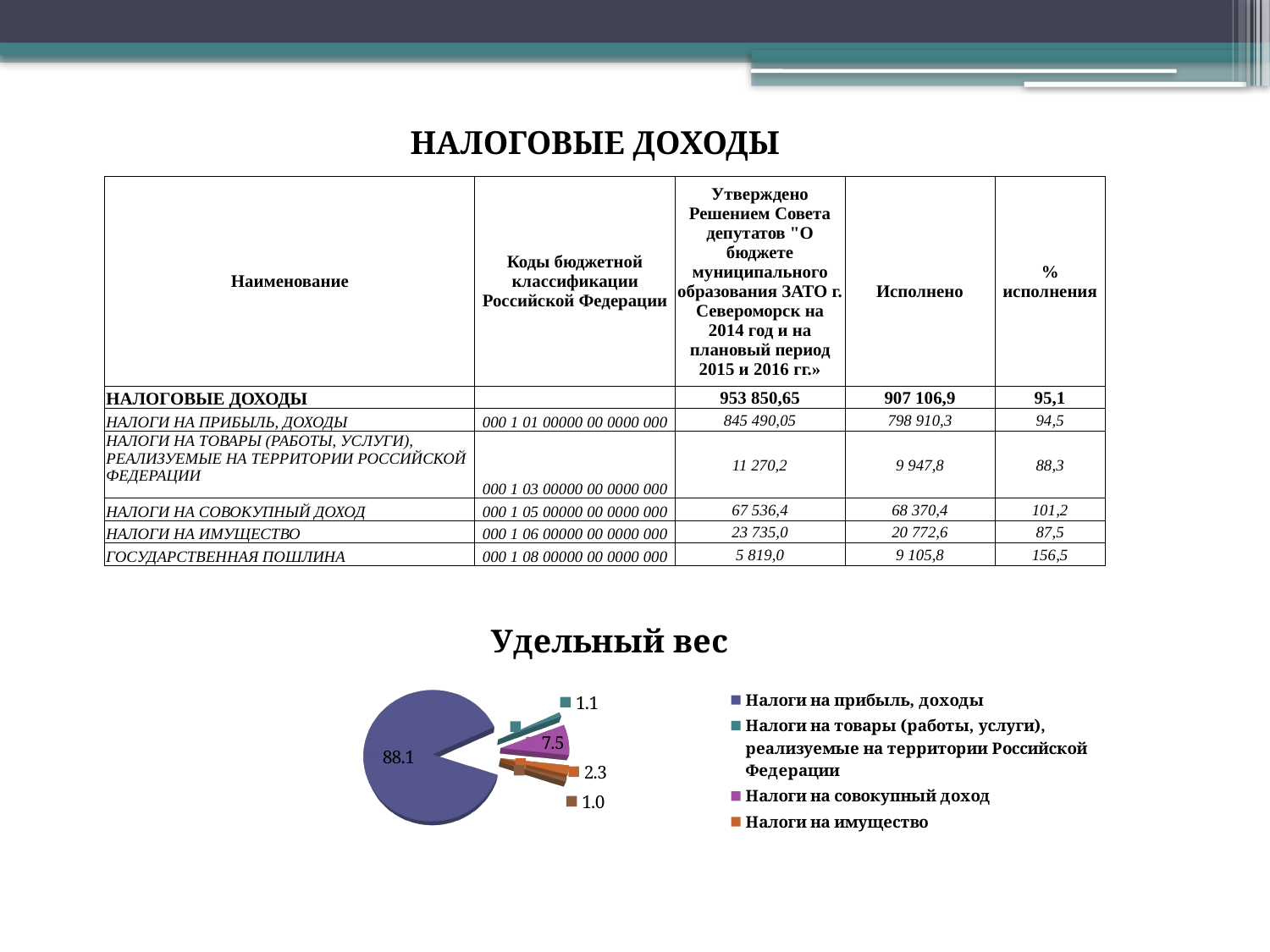
In the "Удельный вес" pie chart, what value is shown for "Налоги на совокупный доход"? 7.5 How many entries does the legend of the "Удельный вес" pie chart list? 4 In the "Удельный вес" pie chart, which is larger: "Налоги на совокупный доход" or "Налоги на имущество"? Налоги на совокупный доход What is the smallest value labeled on the "Удельный вес" pie chart? 1.0 In the "Удельный вес" pie chart, what value is shown for "Налоги на прибыль, доходы"? 88.1 What is the title of the pie chart on the slide? Удельный вес How many slices does the "Удельный вес" pie chart have? 5 In the "Удельный вес" pie chart, what value is shown for "Налоги на товары (работы, услуги), реализуемые на территории Российской Федерации"? 1.1 Which category has the largest slice in the "Удельный вес" pie chart? Налоги на прибыль, доходы In the "Удельный вес" pie chart, what value is shown for "Налоги на имущество"? 2.3 What type of chart is shown under the heading "Удельный вес"? Pie chart In the "Удельный вес" pie chart, what is the difference between the values for "Налоги на прибыль, доходы" and "Налоги на совокупный доход"? 80.6